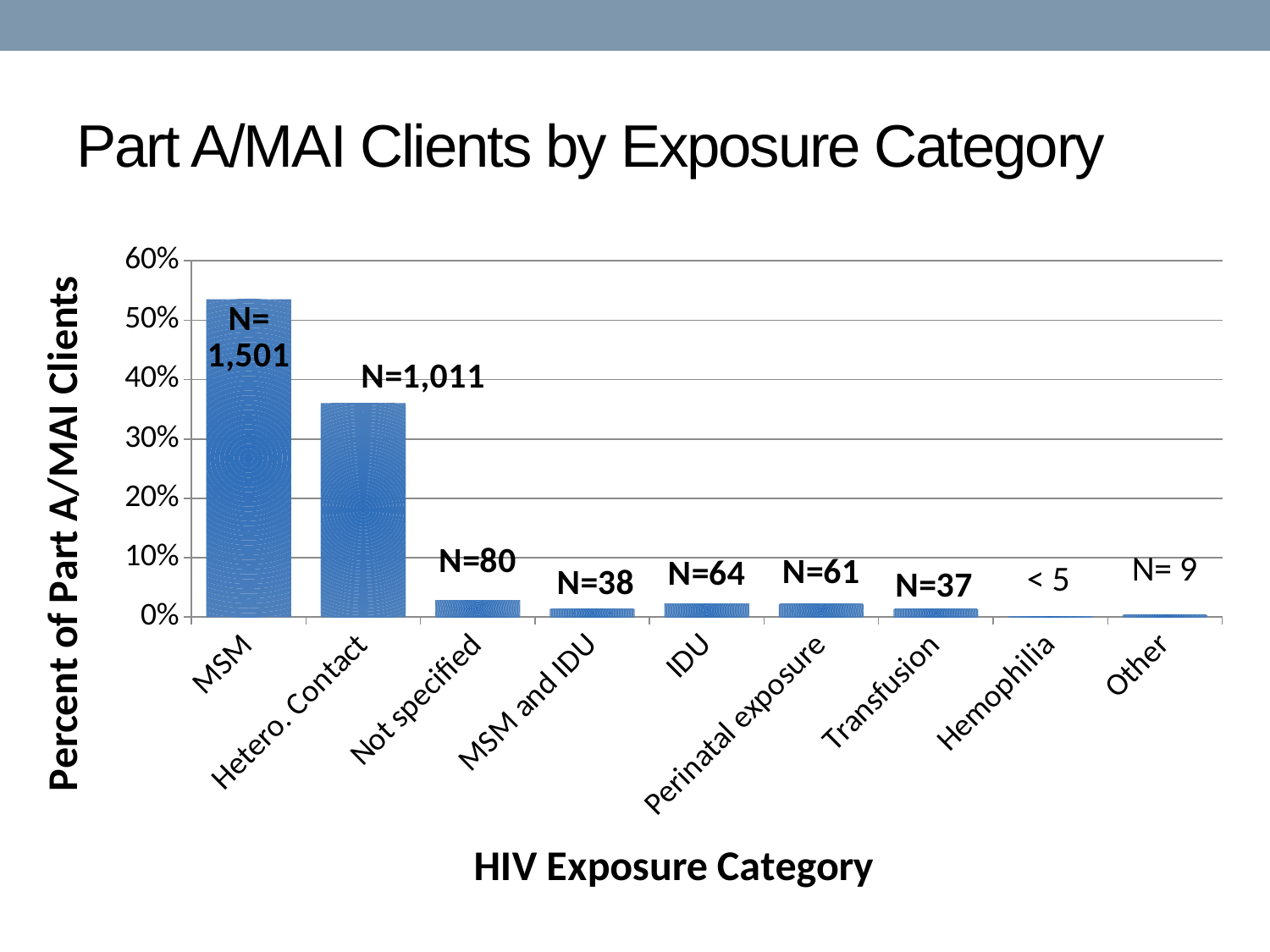
What is the title of the chart? Part A/MAI Clients by Exposure Category What label is shown above the Hemophilia bar? < 5 Which is larger, the value for MSM or the value for Hetero. Contact? MSM Is the value for MSM greater or less than 50%? greater What N value is labelled on the MSM bar? N= 1,501 How many HIV exposure categories are shown on the x axis? 9 Is the value for Hetero. Contact greater or less than 40%? less Which exposure category has the highest percent of Part A/MAI clients? MSM What N value is labelled on the Hetero. Contact bar? N=1,011 What kind of chart is shown on the slide? bar chart Is the value for Hetero. Contact greater or less than 30%? greater